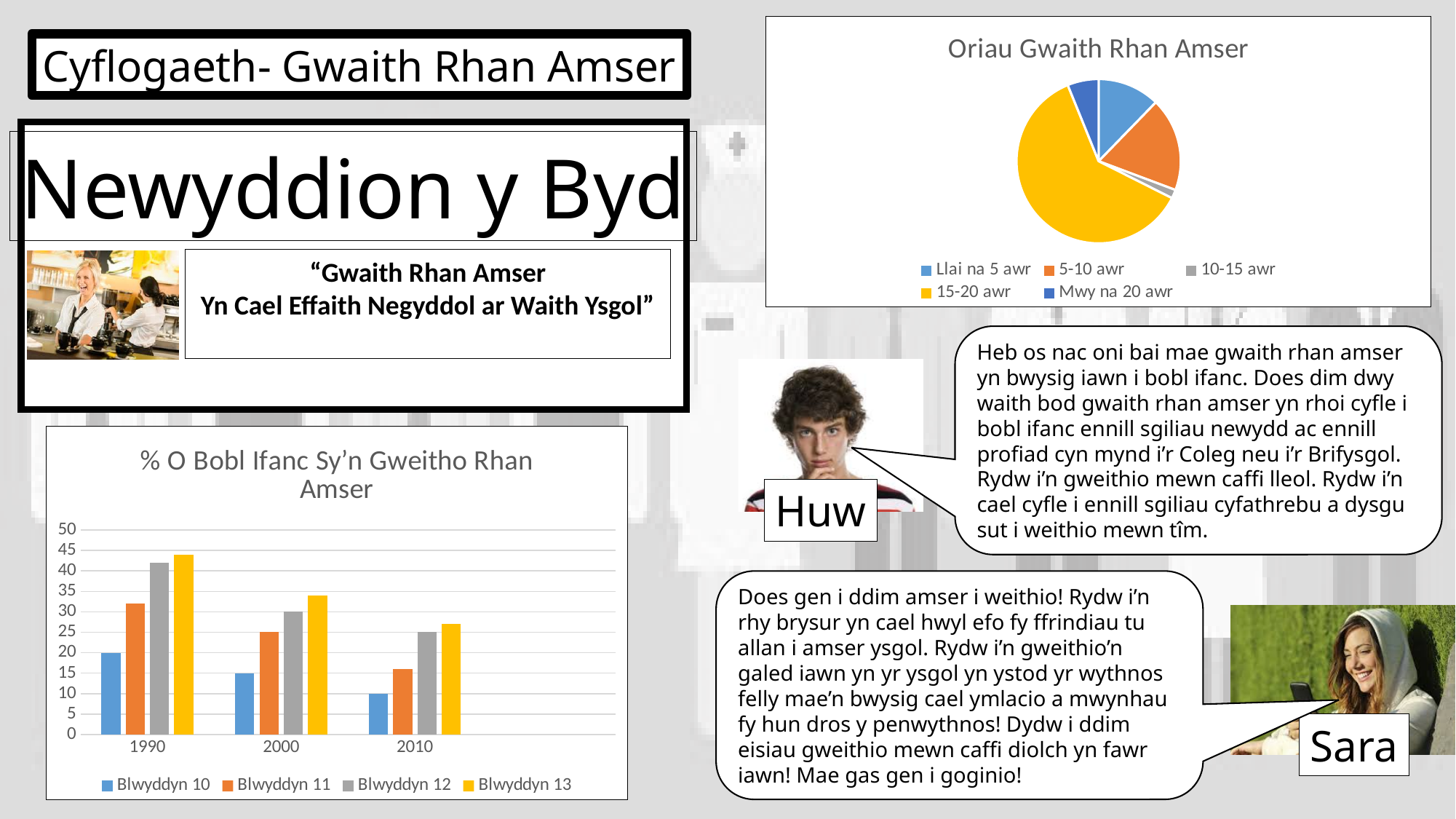
On the bar chart '% O Bobl Ifanc Sy'n Gweitho Rhan Amser', what is the value for Blwyddyn 10 in 2010? 10 On the bar chart '% O Bobl Ifanc Sy'n Gweitho Rhan Amser', how does the value for Blwyddyn 10 change from 1990 to 2010? It falls On the bar chart '% O Bobl Ifanc Sy'n Gweitho Rhan Amser', is the value for Blwyddyn 13 in 1990 greater or less than 40? greater On the bar chart '% O Bobl Ifanc Sy'n Gweitho Rhan Amser', which series has the lowest value in 2010? Blwyddyn 10 On the bar chart '% O Bobl Ifanc Sy'n Gweitho Rhan Amser', how many years are shown on the x axis? 3 On the bar chart '% O Bobl Ifanc Sy'n Gweitho Rhan Amser', is the value for Blwyddyn 11 in 2010 greater or less than 20? less What kind of chart is 'Oriau Gwaith Rhan Amser'? Pie chart On the bar chart '% O Bobl Ifanc Sy'n Gweitho Rhan Amser', what is the value for Blwyddyn 10 in 1990? 20 On the bar chart '% O Bobl Ifanc Sy'n Gweitho Rhan Amser', how many series does the legend list? 4 On the pie chart 'Oriau Gwaith Rhan Amser', which category has the largest slice? 15-20 awr On the bar chart '% O Bobl Ifanc Sy'n Gweitho Rhan Amser', which series has the highest value in 1990? Blwyddyn 13 On the bar chart '% O Bobl Ifanc Sy'n Gweitho Rhan Amser', what is the value for Blwyddyn 12 in 2000? 30